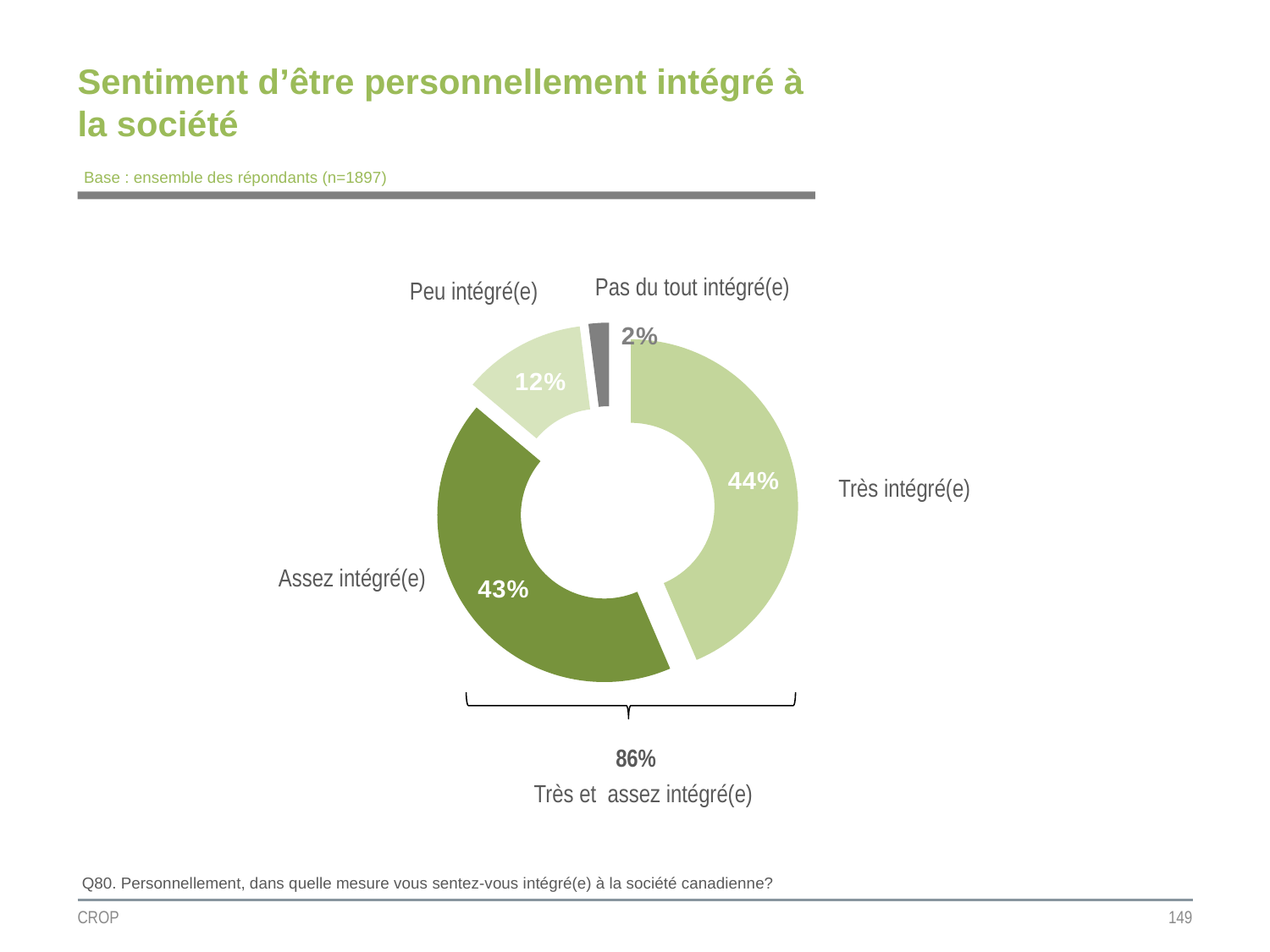
What is the difference between the 'Peu intégré(e)' share and the 'Pas du tout intégré(e)' share? 10 percentage points What percentage of respondents feel 'Peu intégré(e)'? 12% What is the base (number of respondents) stated on the slide? n=1897 What percentage of respondents feel 'Très intégré(e)'? 44% How many categories are shown in the chart? 4 Which category has the smallest share of the chart? Pas du tout intégré(e) What kind of chart is shown on the slide? Doughnut (pie) chart What percentage of respondents feel 'Pas du tout intégré(e)'? 2% What combined percentage is shown for 'Très et assez intégré(e)'? 86% Which category has the largest share of the chart? Très intégré(e) What percentage of respondents feel 'Assez intégré(e)'? 43% Which is larger: the share for 'Assez intégré(e)' or the share for 'Peu intégré(e)'? Assez intégré(e)